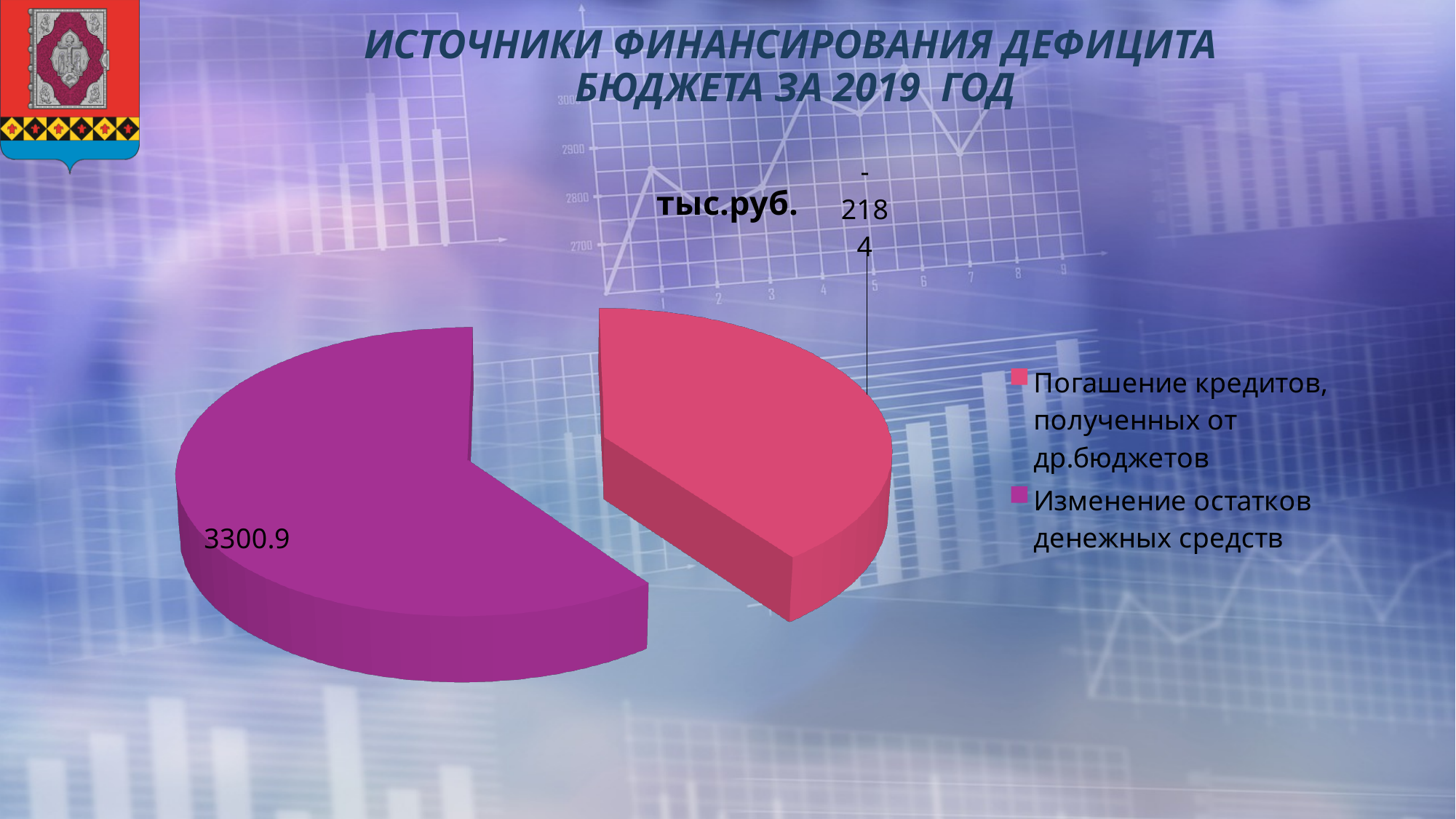
How many slices does the pie chart have? 2 Which category has the smallest slice of the pie? Погашение кредитов, полученных от др.бюджетов What value is shown for "Изменение остатков денежных средств"? 3300.9 Which category has the largest slice of the pie? Изменение остатков денежных средств What value is shown for "Погашение кредитов, полученных от др.бюджетов"? -2184 What kind of chart is shown on the slide? pie chart What colour is the slice for "Погашение кредитов, полученных от др.бюджетов"? pink How many entries does the legend of the pie chart list? 2 Which slice is larger: "Изменение остатков денежных средств" or "Погашение кредитов, полученных от др.бюджетов"? Изменение остатков денежных средств What is the title shown above the pie chart? тыс.руб.